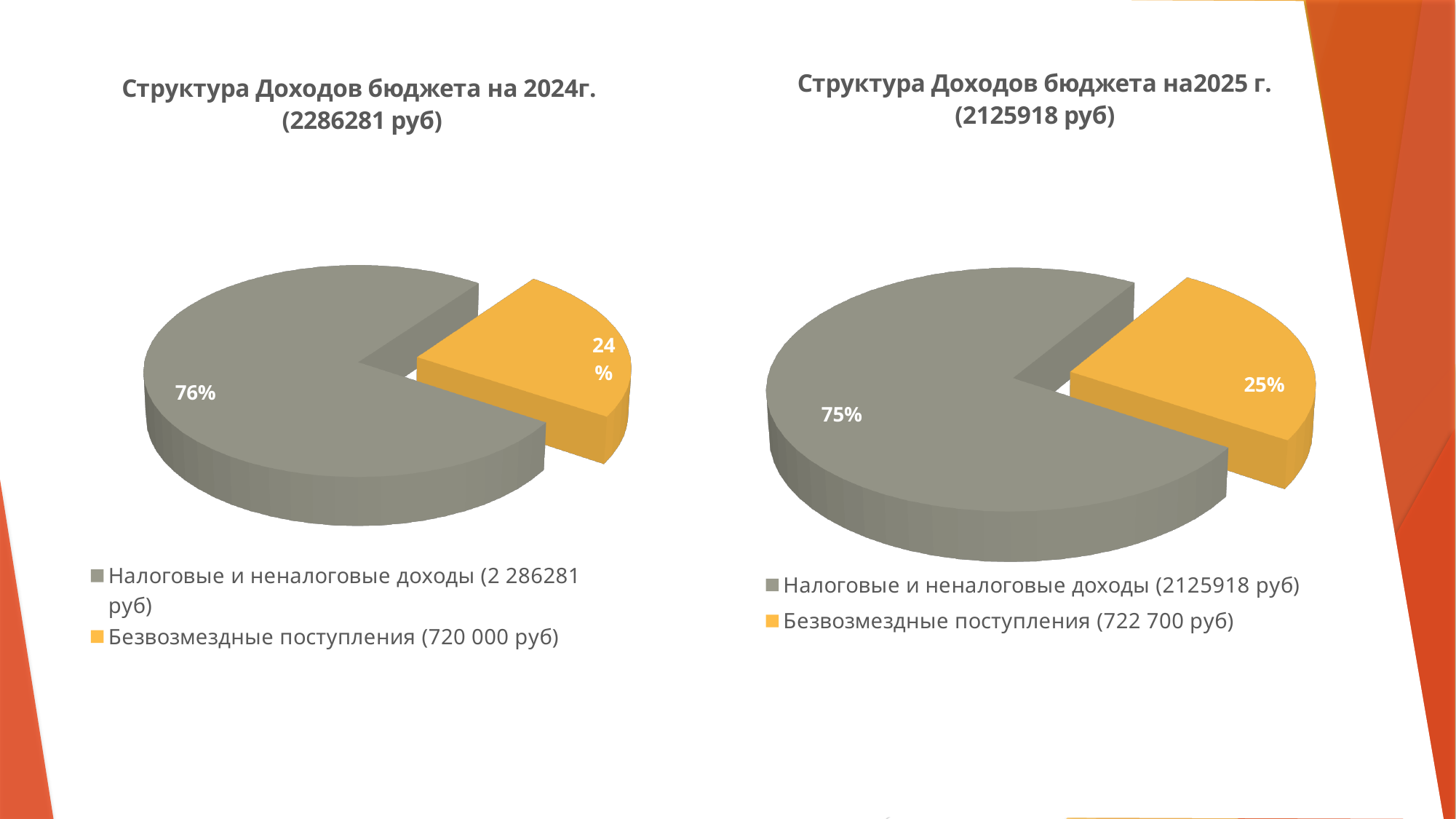
In the 2024 chart on the left, which category has the largest slice? Налоговые и неналоговые доходы In the 2024 chart on the left, what is the difference in percentage points between the two slices? 52 In the 2024 chart on the left, what amount is given in the legend for "Безвозмездные поступления"? 720 000 руб In the chart titled "Структура Доходов бюджета на2025 г.", what share of the pie is "Налоговые и неналоговые доходы"? 75% What kind of chart is shown on the left side of the slide? pie chart How many slices does the 2025 pie chart on the right have? 2 In the 2025 chart on the right, what amount is given in the legend for "Безвозмездные поступления"? 722 700 руб In the chart titled "Структура Доходов бюджета на2025 г.", what share of the pie is "Безвозмездные поступления"? 25% In the chart titled "Структура Доходов бюджета на 2024г.", what share of the pie is "Безвозмездные поступления"? 24% In the 2025 chart on the right, which category has the smallest slice? Безвозмездные поступления In the 2025 chart on the right, what colour is the slice for "Безвозмездные поступления"? orange